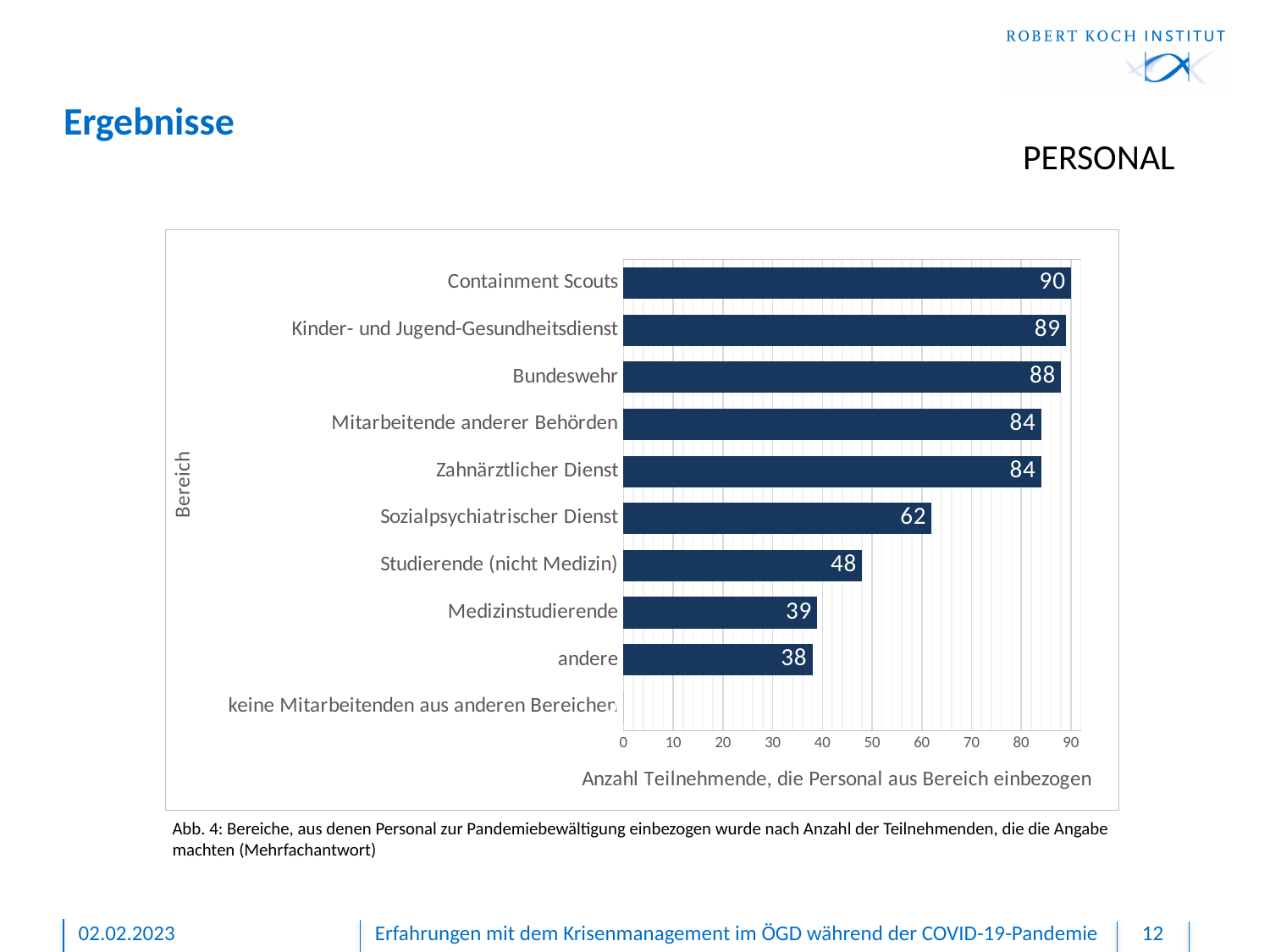
Which is larger, the value for Zahnärztlicher Dienst or the value for Sozialpsychiatrischer Dienst? Zahnärztlicher Dienst What is the difference between the values for Sozialpsychiatrischer Dienst and Studierende (nicht Medizin)? 14 What is the value for Bundeswehr? 88 How many categories are shown on the vertical axis of the chart? 10 What is the value for Containment Scouts? 90 Is the value for Studierende (nicht Medizin) greater or less than 50? less What kind of chart is shown on the slide? bar chart Which category has the highest value? Containment Scouts What is the value for Medizinstudierende? 39 What is the title of the horizontal axis of the chart? Anzahl Teilnehmende, die Personal aus Bereich einbezogen What is the difference between the values for Containment Scouts and andere? 52 What is the value for Sozialpsychiatrischer Dienst? 62